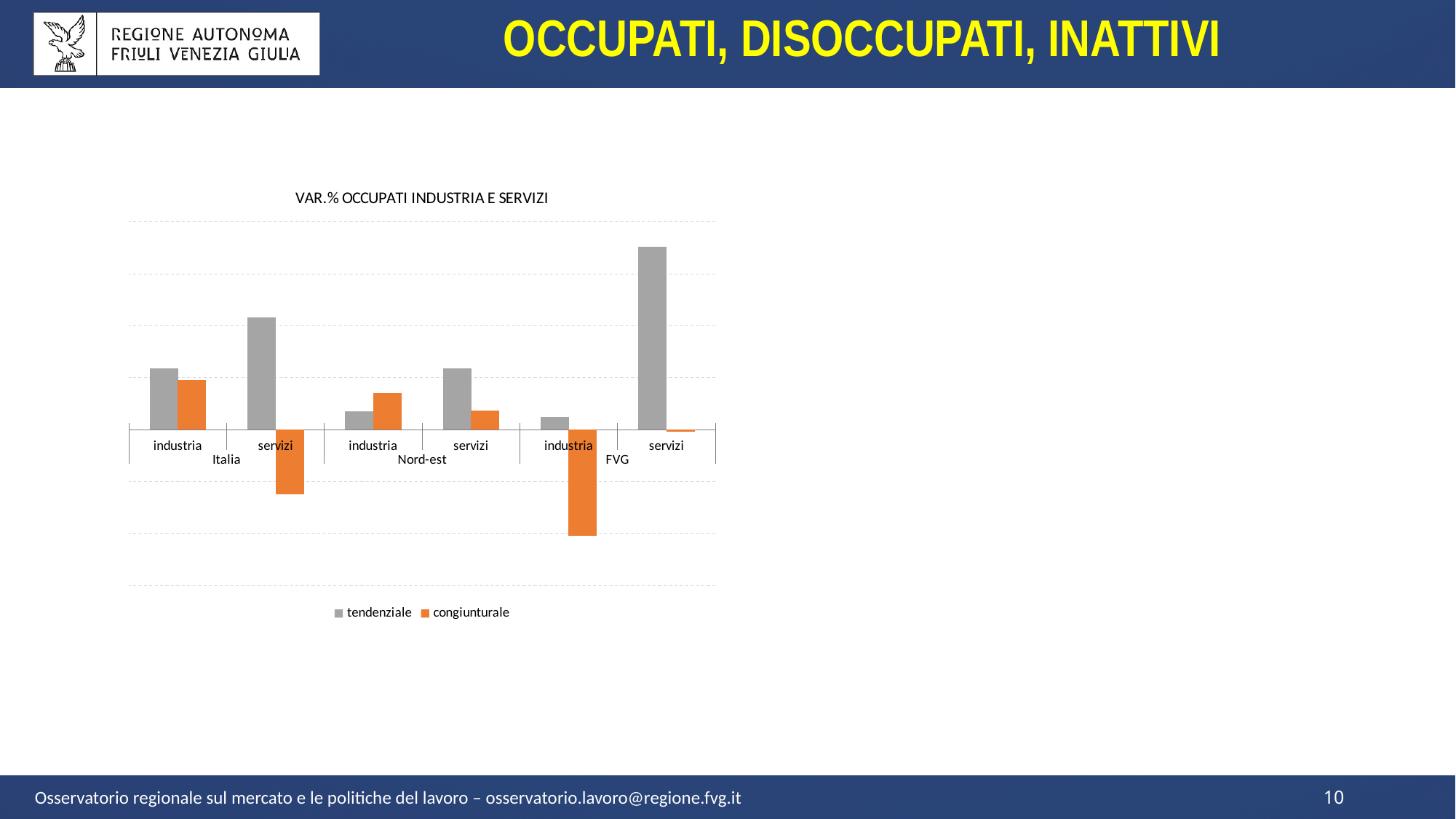
Which series is shown in orange in the chart? congiunturale How many regional groups (Italia, Nord-est, FVG) are shown on the x axis? 3 What kind of chart is shown on the slide? bar chart What is the title of the chart? VAR.% OCCUPATI INDUSTRIA E SERVIZI Which category has the lowest congiunturale value? industria (FVG) For the tendenziale series, which is larger: servizi in Italia or servizi in Nord-est? servizi in Italia Which category has the lowest tendenziale value? industria (FVG) How many series does the chart legend list? 2 Which category has the highest congiunturale value? industria (Italia) For the congiunturale series, which is larger: industria in Nord-est or servizi in Nord-est? industria in Nord-est How many bars are plotted for the tendenziale series? 6 Which category has the highest tendenziale value? servizi (FVG)